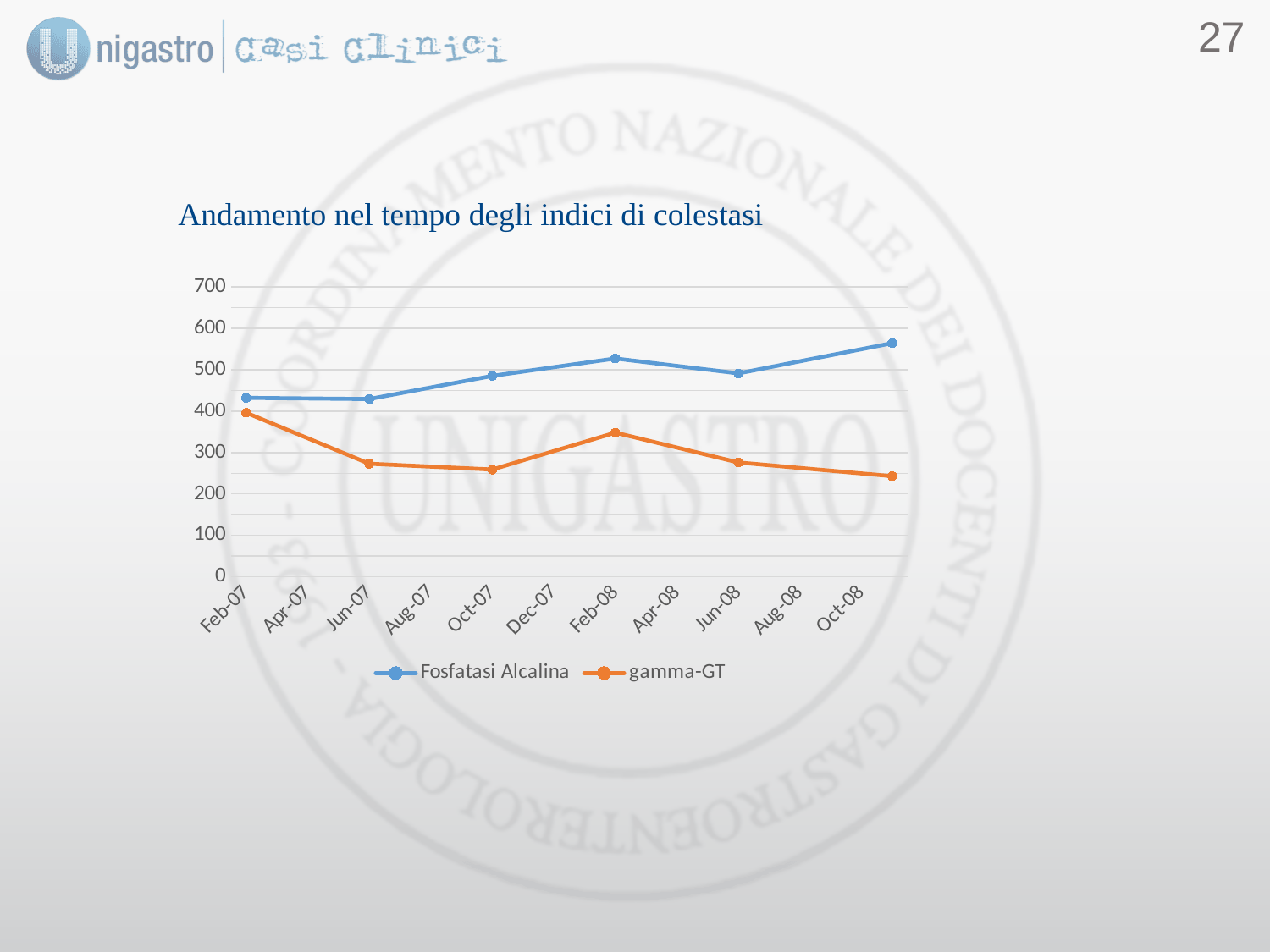
Does the Fosfatasi Alcalina series overall rise or fall from Feb-07 to Oct-08? rise How many data points are plotted for the Fosfatasi Alcalina series? 6 What kind of chart is shown on the slide? line chart What is the title of the chart? Andamento nel tempo degli indici di colestasi Is the value for Fosfatasi Alcalina at Oct-08 greater or less than 500? greater At Feb-07, which series has the higher value, Fosfatasi Alcalina or gamma-GT? Fosfatasi Alcalina Is the value for gamma-GT at Oct-08 greater or less than 300? less Is the value for Fosfatasi Alcalina at Feb-08 greater or less than 500? greater How many series does the legend list? 2 At which date does the gamma-GT series reach its highest value? Feb-07